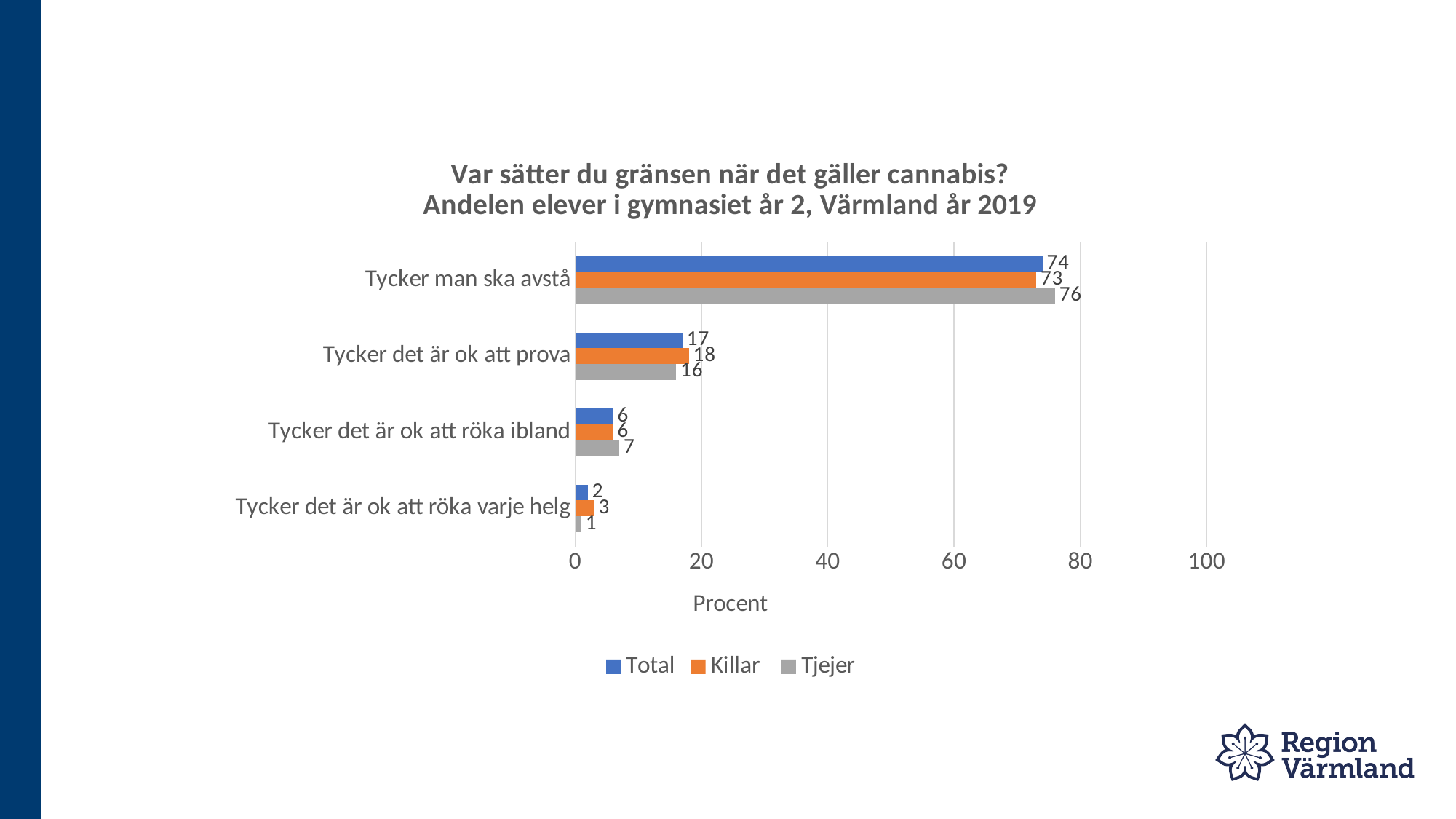
What is the Killar value for "Tycker det är ok att röka varje helg"? 3 What is the label of the x axis? Procent What is the Tjejer value for "Tycker det är ok att prova"? 16 Which category has the lowest Total value? Tycker det är ok att röka varje helg What is the Total value for "Tycker man ska avstå"? 74 What kind of chart is shown on the slide? Bar chart Is the Total value for "Tycker man ska avstå" greater or less than 60? greater For "Tycker det är ok att prova", which is larger, the Killar value or the Tjejer value? Killar What is the difference between the Tjejer and Killar values for "Tycker man ska avstå"? 3 Which category has the highest Tjejer value? Tycker man ska avstå How many series does the legend list? 3 How many categories are shown on the y axis? 4